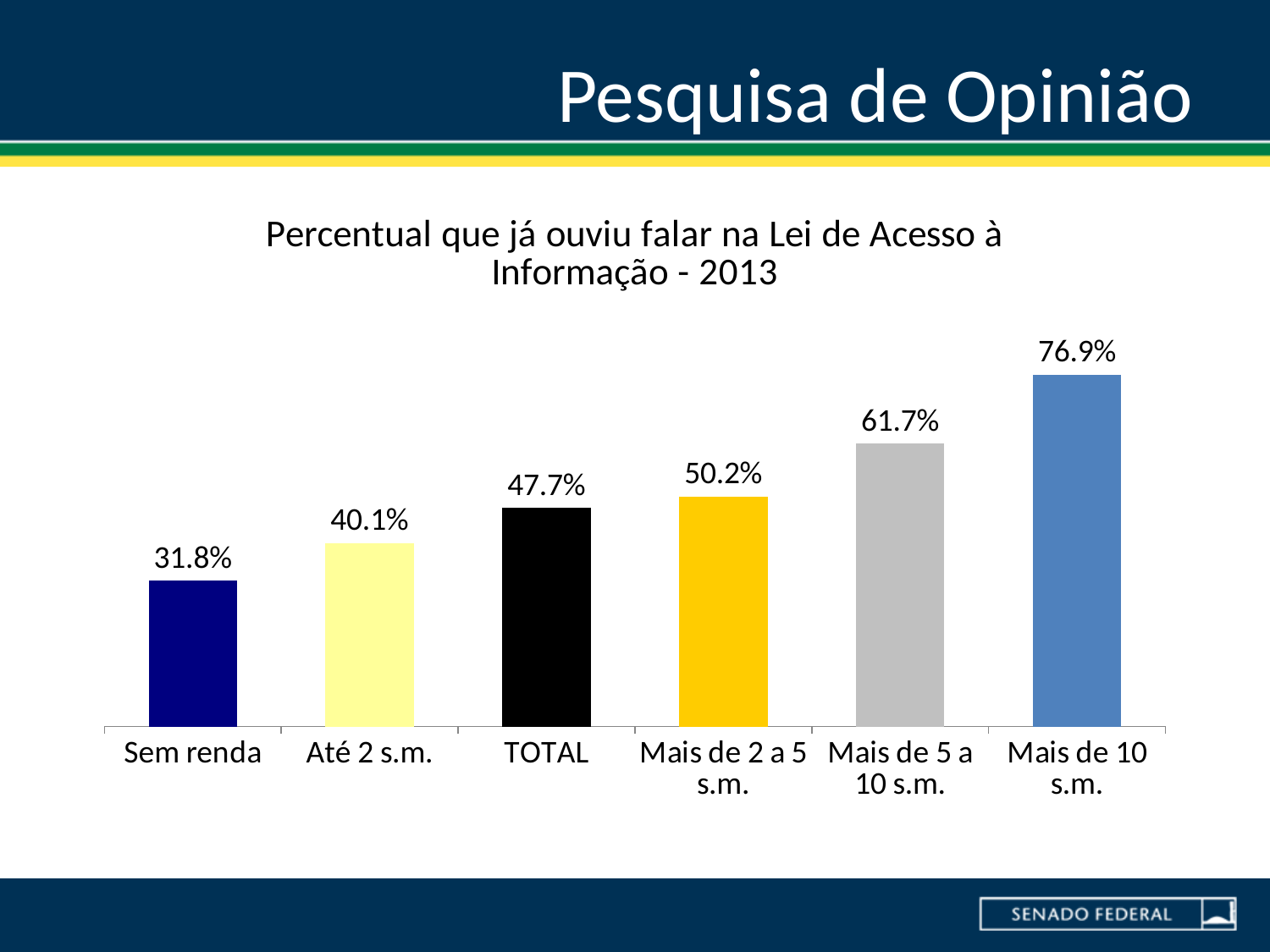
What is the difference between the values for "Mais de 2 a 5 s.m." and "Até 2 s.m."? 10.1% What is the title of the chart? Percentual que já ouviu falar na Lei de Acesso à Informação - 2013 How many categories are shown on the x axis? 6 What is the value for "Mais de 5 a 10 s.m."? 61.7% What is the value for "TOTAL"? 47.7% What is the value for "Sem renda"? 31.8% What is the difference between the values for "Mais de 10 s.m." and "Sem renda"? 45.1% What kind of chart is shown on the slide? Bar chart Which category has the highest value? Mais de 10 s.m. Which is larger, the value for "Até 2 s.m." or the value for "TOTAL"? TOTAL Do the values rise or fall from left to right along the x axis? Rise Which category has the lowest value? Sem renda